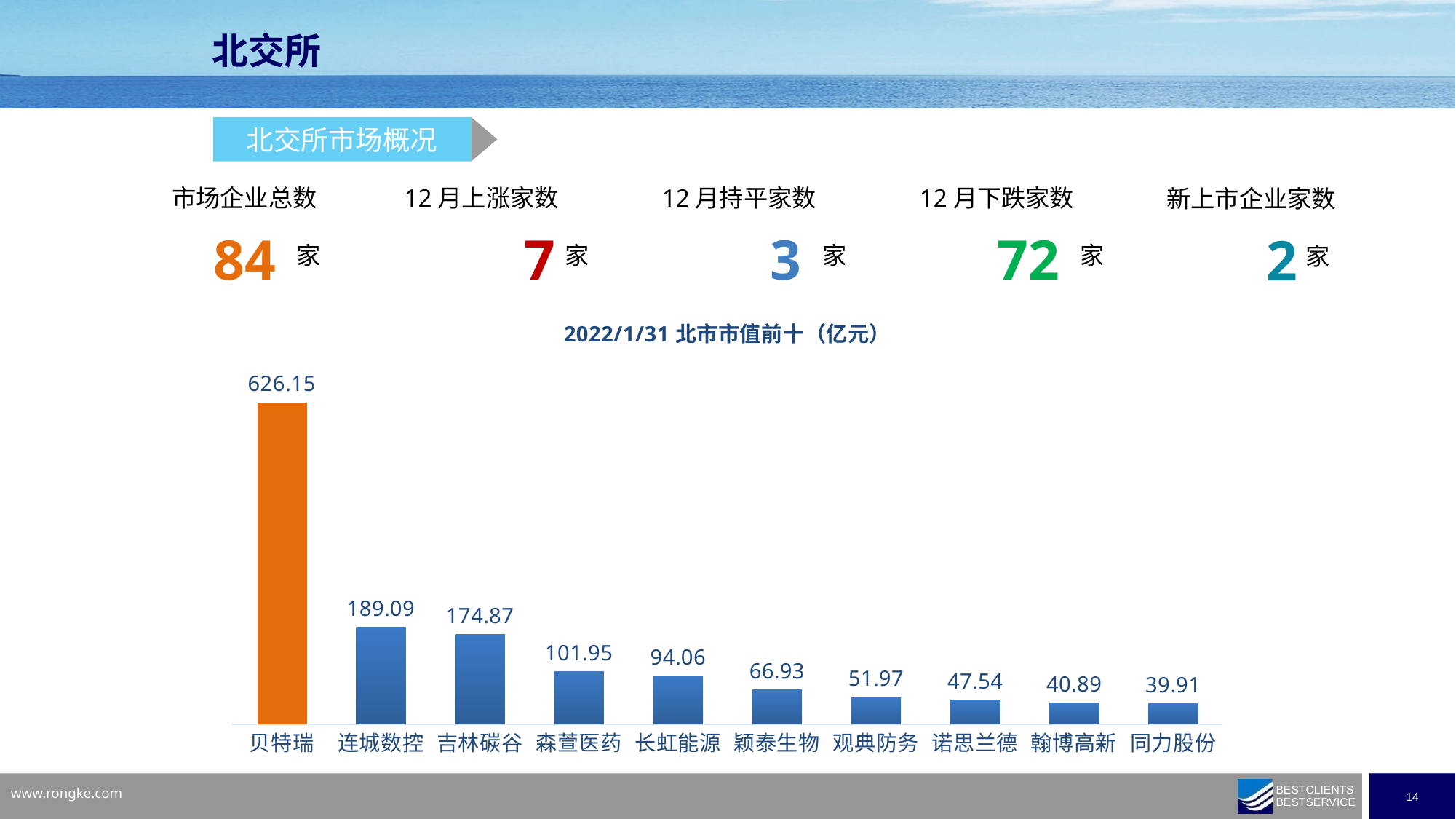
Which company has the lowest market value in the chart? 同力股份 Do the values rise or fall from left to right across the chart? fall Which has a larger market value, 长虹能源 or 颖泰生物? 长虹能源 Which bar is coloured orange rather than blue? 贝特瑞 What is the title of the chart? 2022/1/31 北市市值前十（亿元） What is the market value shown for 贝特瑞? 626.15 What is the market value shown for 森萱医药? 101.95 What is the market value shown for 翰博高新? 40.89 What is the difference between the market values of 连城数控 and 吉林碳谷? 14.22 Which company has the highest market value in the chart? 贝特瑞 How many companies are shown in the chart? 10 What type of chart is used to show the top ten market values? bar chart